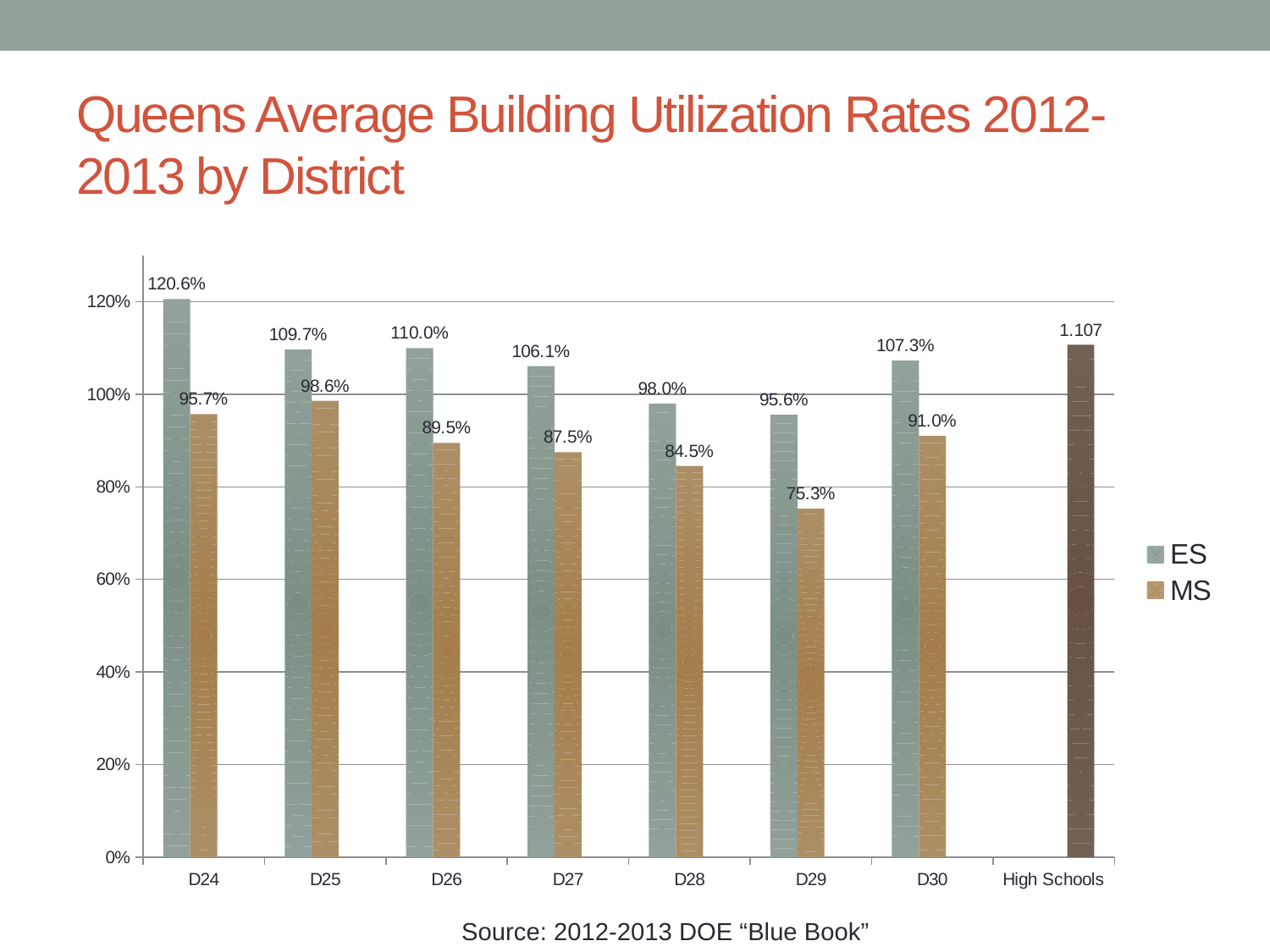
Is the MS value for D29 greater or less than 80%? less What is the difference between the ES and MS utilization rates for D24? 24.9 percentage points What is the MS utilization rate for D29? 75.3% What kind of chart is shown on the slide? Bar chart Which is larger: the ES rate for D28 or the MS rate for D30? ES rate for D28 Which district has the lowest MS utilization rate? D29 How many categories are shown on the x axis? 8 Which district has the highest ES utilization rate? D24 What is the ES utilization rate for D24? 120.6% Do the MS utilization rates rise or fall from D26 to D29? Fall How many series does the legend list? 2 What value is shown for the High Schools bar? 1.107